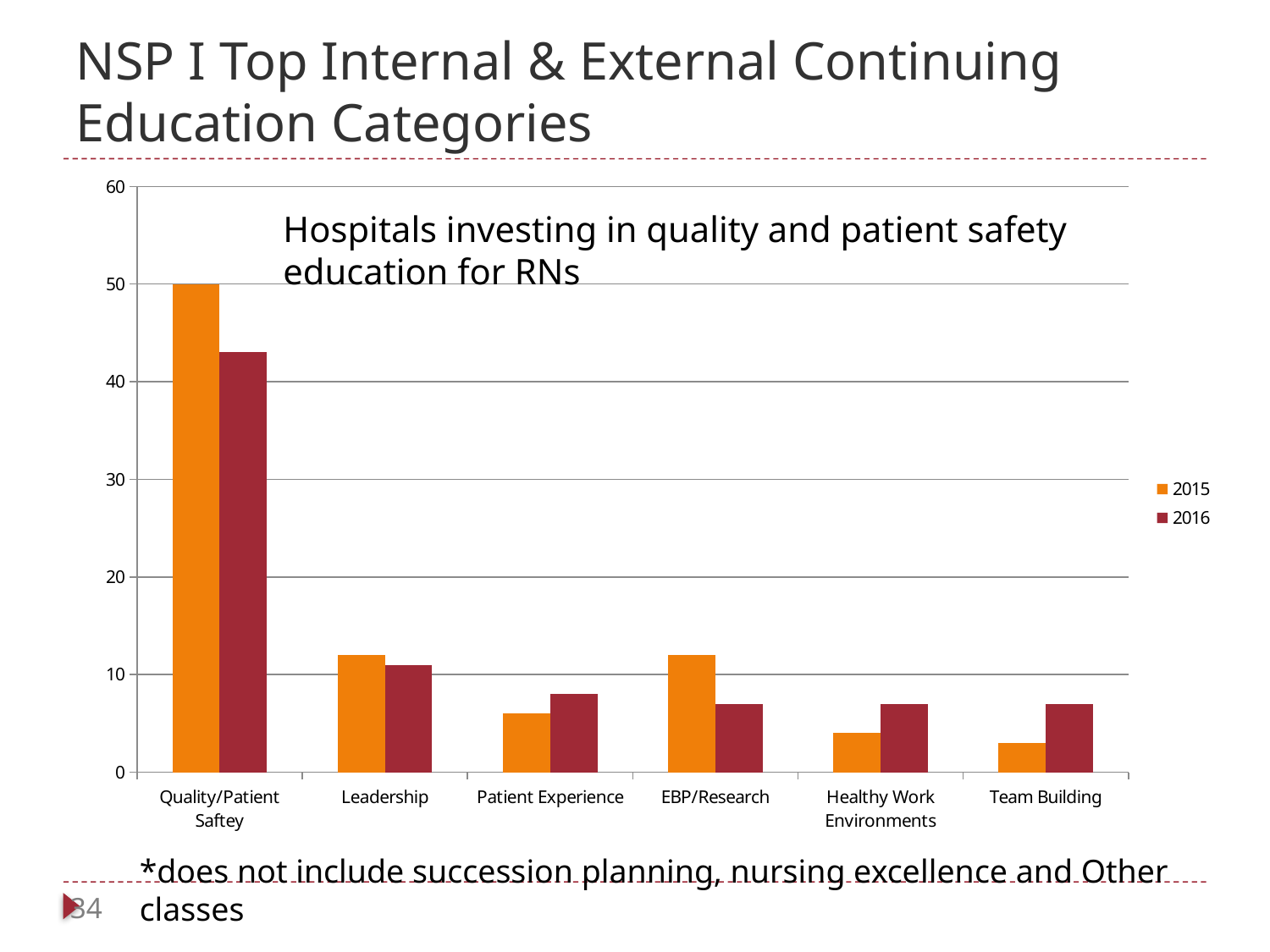
What are the two entries listed in the chart legend? 2015 and 2016 Which category has the highest 2015 value? Quality/Patient Saftey How many series does the legend list? 2 What kind of chart is shown on the slide? bar chart How many categories are shown on the x axis? 6 For EBP/Research, which is larger, the 2015 value or the 2016 value? 2015 What is the 2015 value for Quality/Patient Saftey? 50 Which category has the highest 2016 value? Quality/Patient Saftey Is the 2015 value for Team Building greater or less than 10? less Is the 2016 value for Quality/Patient Saftey greater or less than 40? greater Is the 2015 value for Leadership greater or less than 10? greater For Healthy Work Environments, which is larger, the 2015 value or the 2016 value? 2016